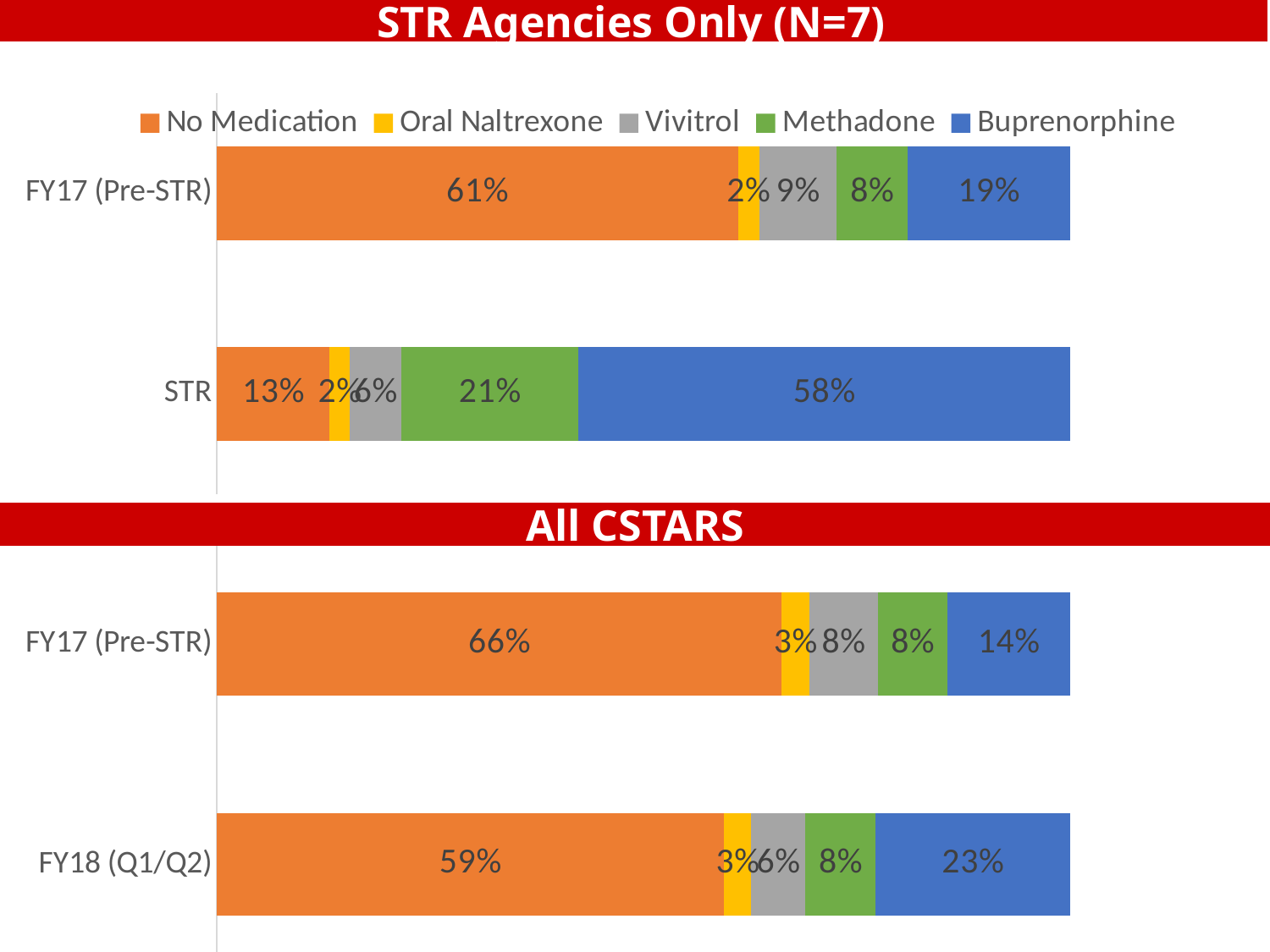
In the 'STR Agencies Only (N=7)' chart, what is the Methadone share for STR? 21% In the 'All CSTARS' chart, is the Buprenorphine share larger for FY17 (Pre-STR) or FY18 (Q1/Q2)? FY18 (Q1/Q2) In the 'All CSTARS' chart, what is the No Medication share for FY17 (Pre-STR)? 66% In the 'All CSTARS' chart, which series has the largest share in the FY18 (Q1/Q2) bar? No Medication How many series does the legend on the 'STR Agencies Only (N=7)' chart list? 5 In the 'STR Agencies Only (N=7)' chart, what is the No Medication share for FY17 (Pre-STR)? 61% In the 'STR Agencies Only (N=7)' chart, what is the difference in Buprenorphine share between STR and FY17 (Pre-STR)? 39% In the 'STR Agencies Only (N=7)' chart, which series has the largest share in the STR bar? Buprenorphine What type of chart is the 'All CSTARS' chart? Stacked bar chart In the 'All CSTARS' chart, what is the difference in No Medication share between FY17 (Pre-STR) and FY18 (Q1/Q2)? 7% In the 'STR Agencies Only (N=7)' chart, what is the Buprenorphine share for STR? 58% In the 'All CSTARS' chart, what is the Buprenorphine share for FY18 (Q1/Q2)? 23%